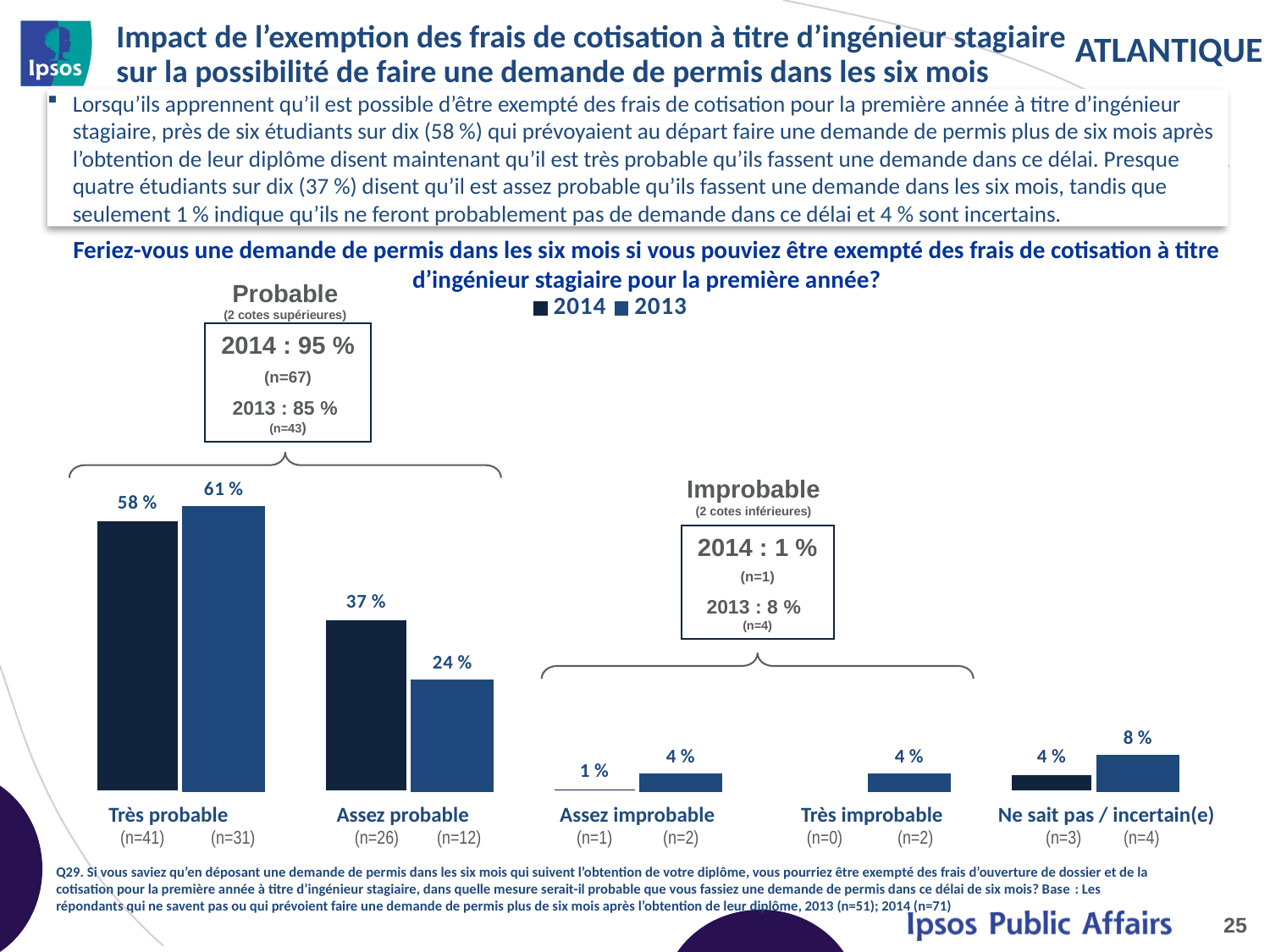
Which category has the lowest 2013 value? Assez improbable and Très improbable (tied at 4 %) What is the 2013 value for "Ne sait pas / incertain(e)"? 8 % How many series does the legend list? 2 What is the 2014 value for "Assez improbable"? 1 % What kind of chart is shown? Bar chart How many categories are shown on the x axis? 5 For "Très probable", which year has the larger value, 2014 or 2013? 2013 What is the 2014 value for "Très probable"? 58 % Which category has the highest 2014 value? Très probable What is the 2014 "Probable" total (2 cotes supérieures) shown in the box above the chart? 95 % What is the difference between the 2014 and 2013 values for "Assez probable"? 13 % What is the 2013 value for "Assez probable"? 24 %